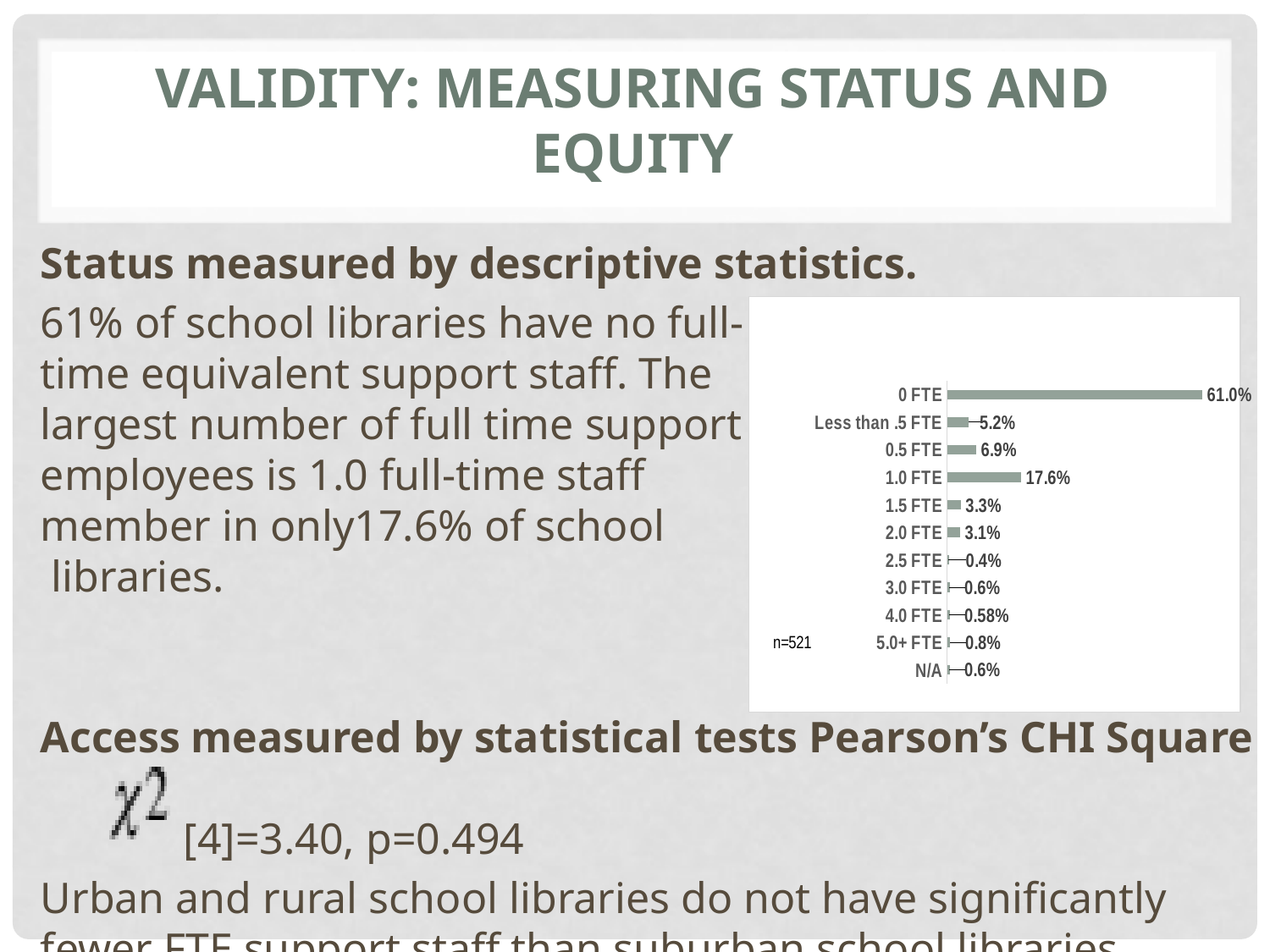
What is the value shown for 1.0 FTE in the chart? 17.6% What type of chart is shown on the slide? Bar chart Which is larger, the value for 1.5 FTE or the value for 2.0 FTE? 1.5 FTE What percentage of school libraries have 0 FTE support staff according to the chart? 61.0% What is the value shown for 0.5 FTE in the chart? 6.9% Which category has the lowest value in the chart? 2.5 FTE Which category has the highest value in the chart? 0 FTE What is the difference between the values for 0.5 FTE and Less than .5 FTE? 1.7% What sample size (n) is noted next to the chart? n=521 How many categories are shown in the chart? 11 What is the difference between the values for 0 FTE and 1.0 FTE? 43.4% What is the value shown for 4.0 FTE in the chart? 0.58%